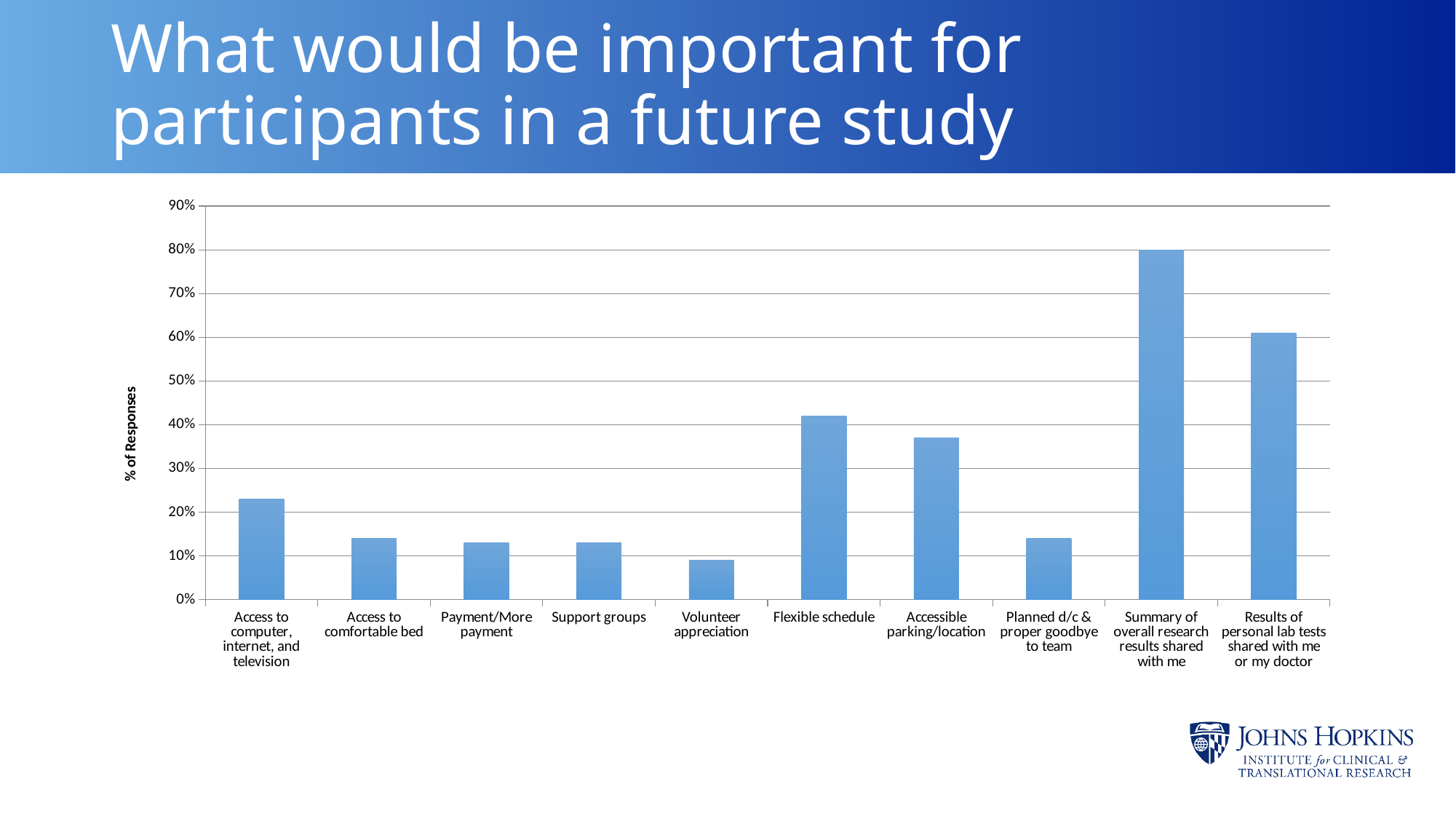
Is the value for Access to computer, internet, and television greater or less than 20%? greater Is the value for Accessible parking/location greater or less than 40%? less What is the label on the vertical axis of the chart? % of Responses How many categories are shown on the x axis of the chart? 10 Which is larger, the value for Flexible schedule or the value for Accessible parking/location? Flexible schedule Which category has the lowest value in the chart? Volunteer appreciation Which is larger, the value for Summary of overall research results shared with me or the value for Results of personal lab tests shared with me or my doctor? Summary of overall research results shared with me Is the value for Flexible schedule greater or less than 40%? greater What kind of chart is shown on the slide? bar chart Which category has the highest value in the chart? Summary of overall research results shared with me